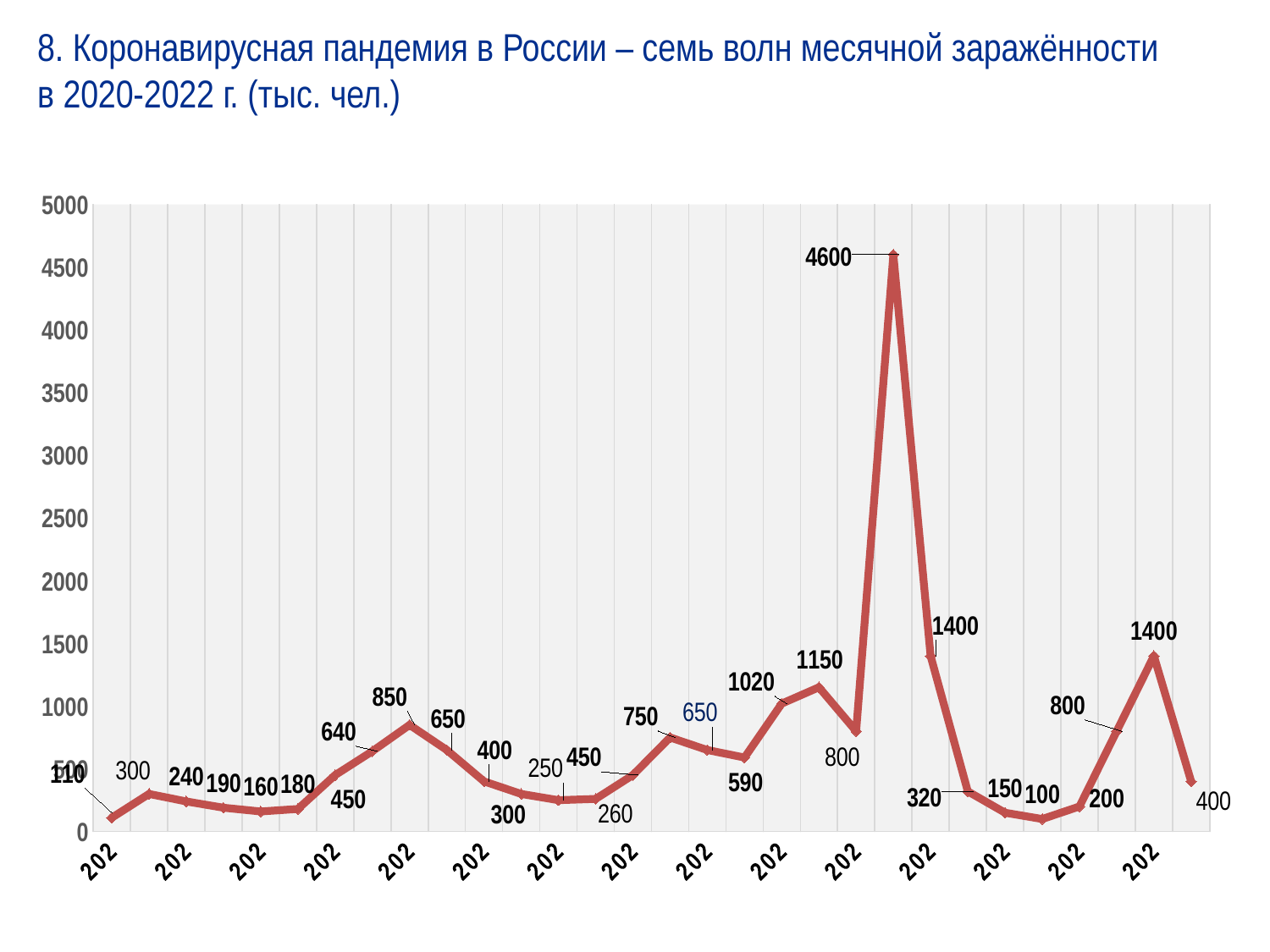
What kind of chart is shown on the slide? line chart Do the values rise or fall immediately after the 4600 peak? fall What is the lowest value plotted on the chart? 100 What is the value of the last data point on the right of the chart? 400 Is the peak value on the chart greater or less than 4500? greater What is the value of the first data point on the left of the chart? 110 What is the difference between the last data point (400) and the first data point (110)? 290 Which is larger, the first data point or the last data point on the chart? the last data point (400) What is the maximum value shown on the vertical axis? 5000 What is the highest value plotted on the chart? 4600 What is the difference between the peak value of 4600 and the value of the point immediately after it (1400)? 3200 How many data points are plotted on the line? 30